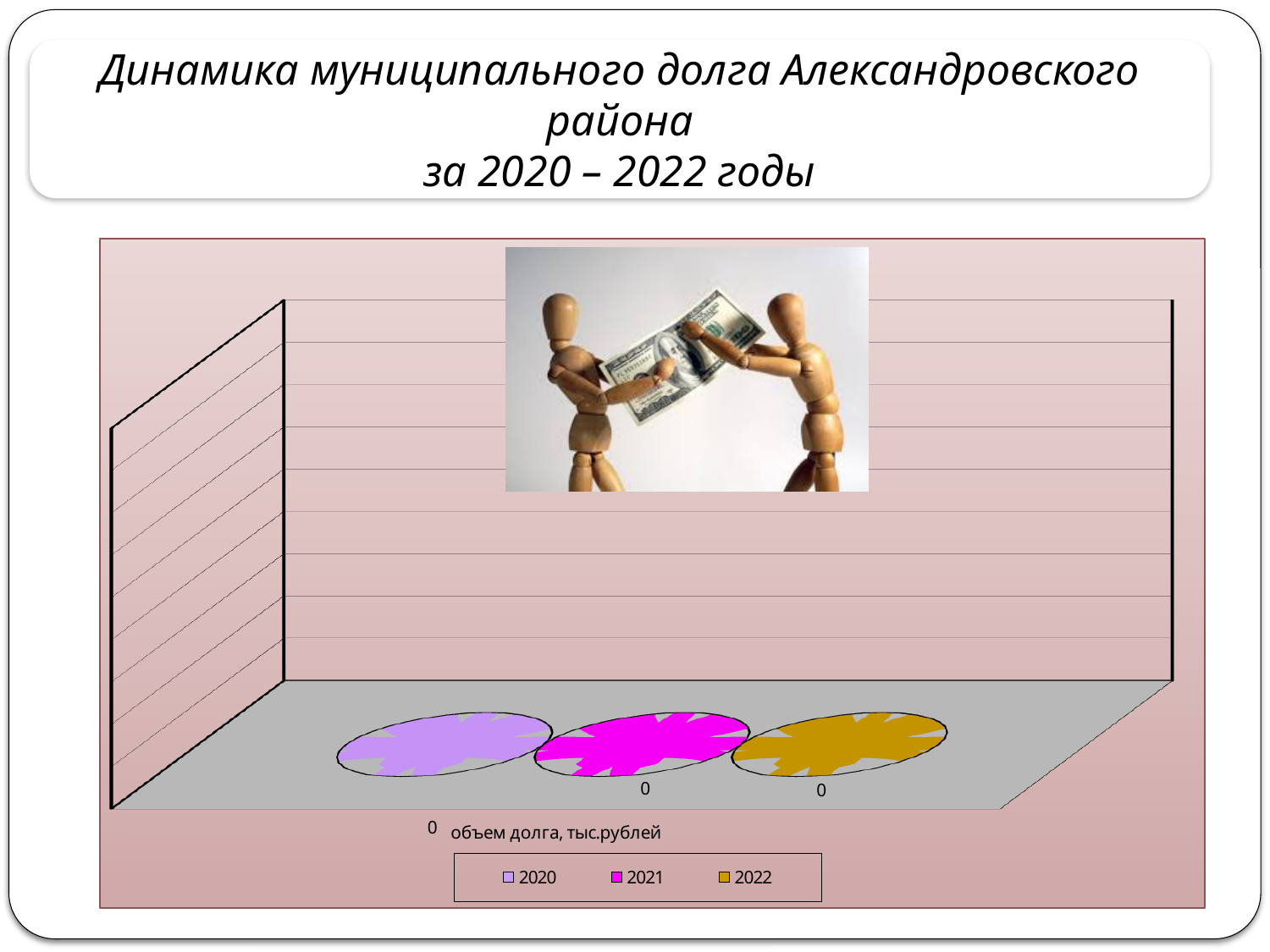
Which series is shown in magenta in the legend? 2021 How many categories are shown on the x axis? 1 What is the difference between the 2021 and 2020 values for объем долга, тыс.рублей? 0 What is the value for 2021 for объем долга, тыс.рублей? 0 What is the difference between the 2022 and 2021 values for объем долга, тыс.рублей? 0 What is the category label on the x axis? объем долга, тыс.рублей Do the values rise, fall or stay the same from 2020 to 2022? stay the same What is the value for 2022 for объем долга, тыс.рублей? 0 What is the value for 2020 for объем долга, тыс.рублей? 0 What kind of chart is shown on the slide? bar chart How many series does the legend list? 3 What is the title of the slide? Динамика муниципального долга Александровского района за 2020 – 2022 годы